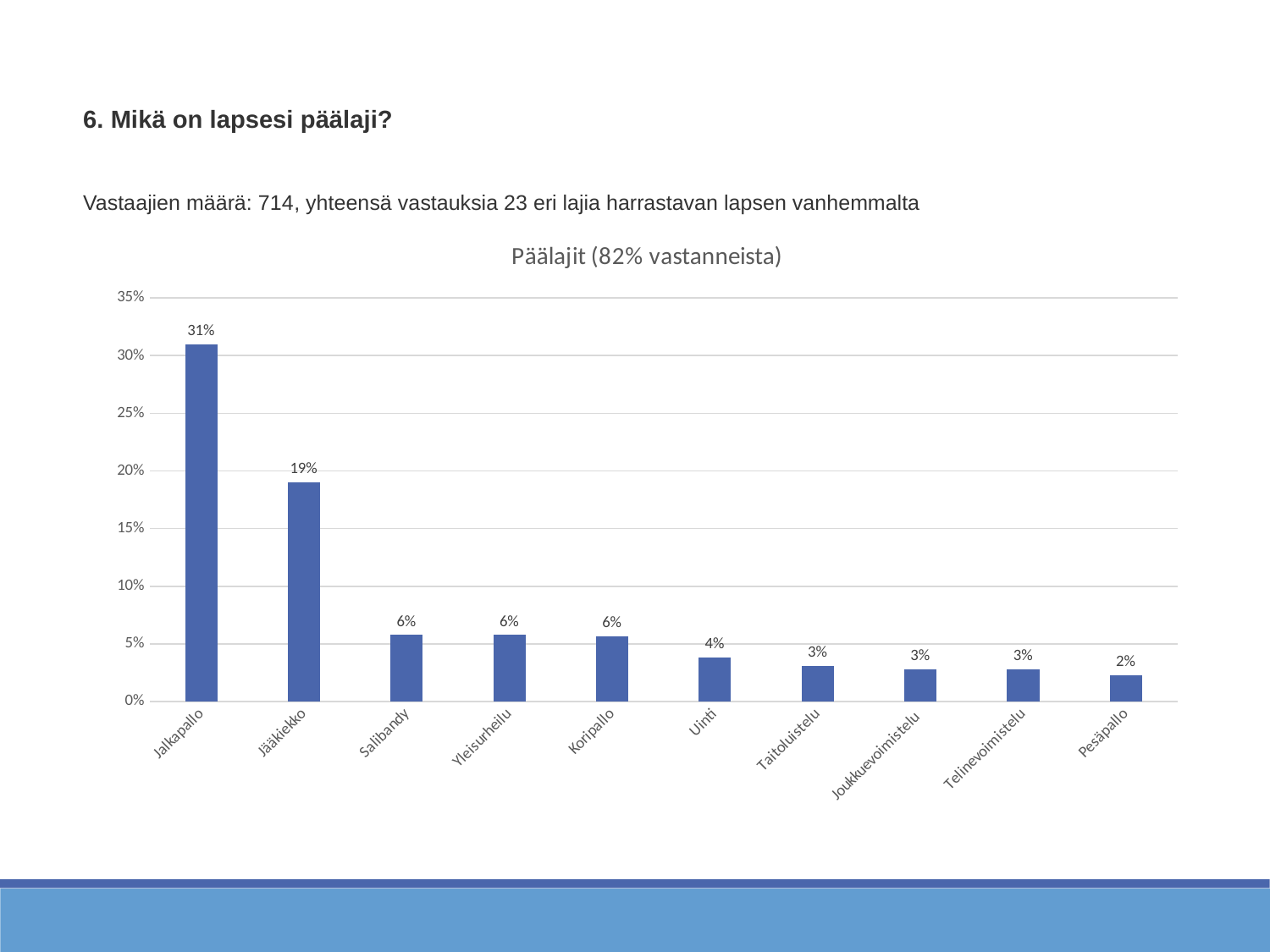
What is the value for Jalkapallo? 31% What is the value for Jääkiekko? 19% Which is larger, the value for Jääkiekko or the value for Salibandy? Jääkiekko Which category has the lowest value? Pesäpallo What kind of chart is shown on the slide? bar chart Which category has the highest value? Jalkapallo How many categories are shown on the x axis? 10 What is the value for Uinti? 4% What is the title of the chart? Päälajit (82% vastanneista) Is the value for Jalkapallo greater or less than 30%? greater What is the value for Pesäpallo? 2% What is the difference between the values for Jalkapallo and Jääkiekko? 12%